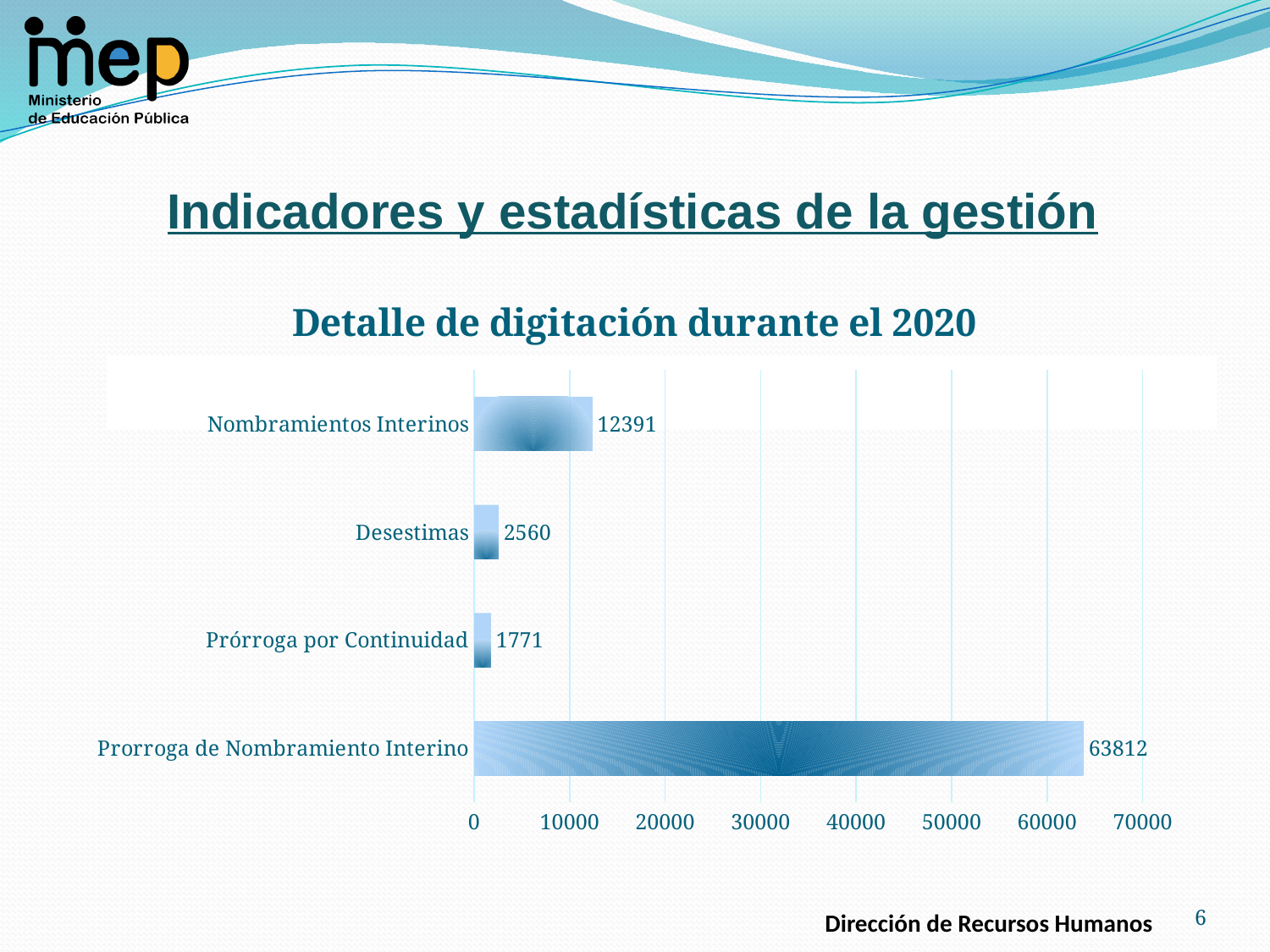
What is the value for Nombramientos Interinos? 12391 Which category has the lowest value? Prórroga por Continuidad What is the difference between Desestimas and Prórroga por Continuidad? 789 What is the difference between Prorroga de Nombramiento Interino and Nombramientos Interinos? 51421 Is the value for Prorroga de Nombramiento Interino greater or less than 60000? greater What is the value for Prórroga por Continuidad? 1771 What is the value for Prorroga de Nombramiento Interino? 63812 What kind of chart is shown on the slide? bar chart How many categories are shown in the chart? 4 What is the value for Desestimas? 2560 Which category has the highest value? Prorroga de Nombramiento Interino Which is larger, Nombramientos Interinos or Desestimas? Nombramientos Interinos